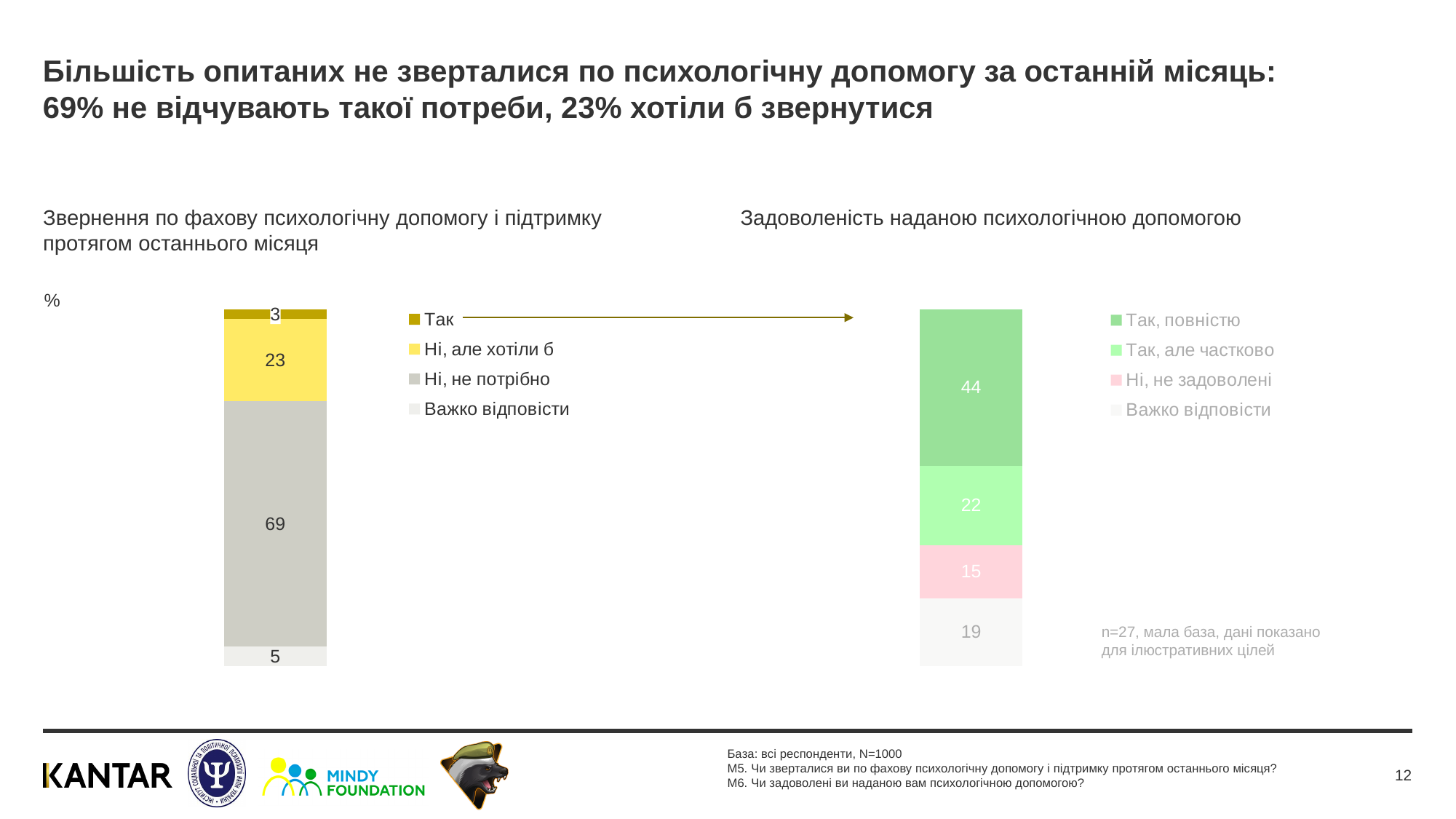
In the right chart 'Задоволеність наданою психологічною допомогою', what is the value for 'Ні, не задоволені'? 15 In the left chart 'Звернення по фахову психологічну допомогу і підтримку протягом останнього місяця', what is the difference between 'Ні, не потрібно' and 'Ні, але хотіли б'? 46 How many entries does the legend of the left chart 'Звернення по фахову психологічну допомогу і підтримку протягом останнього місяця' list? 4 In the left chart 'Звернення по фахову психологічну допомогу і підтримку протягом останнього місяця', which segment has the smallest value? Так In the left chart 'Звернення по фахову психологічну допомогу і підтримку протягом останнього місяця', what is the value for 'Так'? 3 In the right chart 'Задоволеність наданою психологічною допомогою', what is the value for 'Так, повністю'? 44 In the right chart 'Задоволеність наданою психологічною допомогою', which is larger: 'Так, але частково' or 'Важко відповісти'? Так, але частково What type of chart is the left chart 'Звернення по фахову психологічну допомогу і підтримку протягом останнього місяця'? Stacked bar chart In the left chart 'Звернення по фахову психологічну допомогу і підтримку протягом останнього місяця', what is the value for 'Ні, не потрібно'? 69 In the right chart 'Задоволеність наданою психологічною допомогою', what is the total of the stacked bar? 100 In the right chart 'Задоволеність наданою психологічною допомогою', which segment has the smallest value? Ні, не задоволені In the left chart 'Звернення по фахову психологічну допомогу і підтримку протягом останнього місяця', which segment has the largest value? Ні, не потрібно